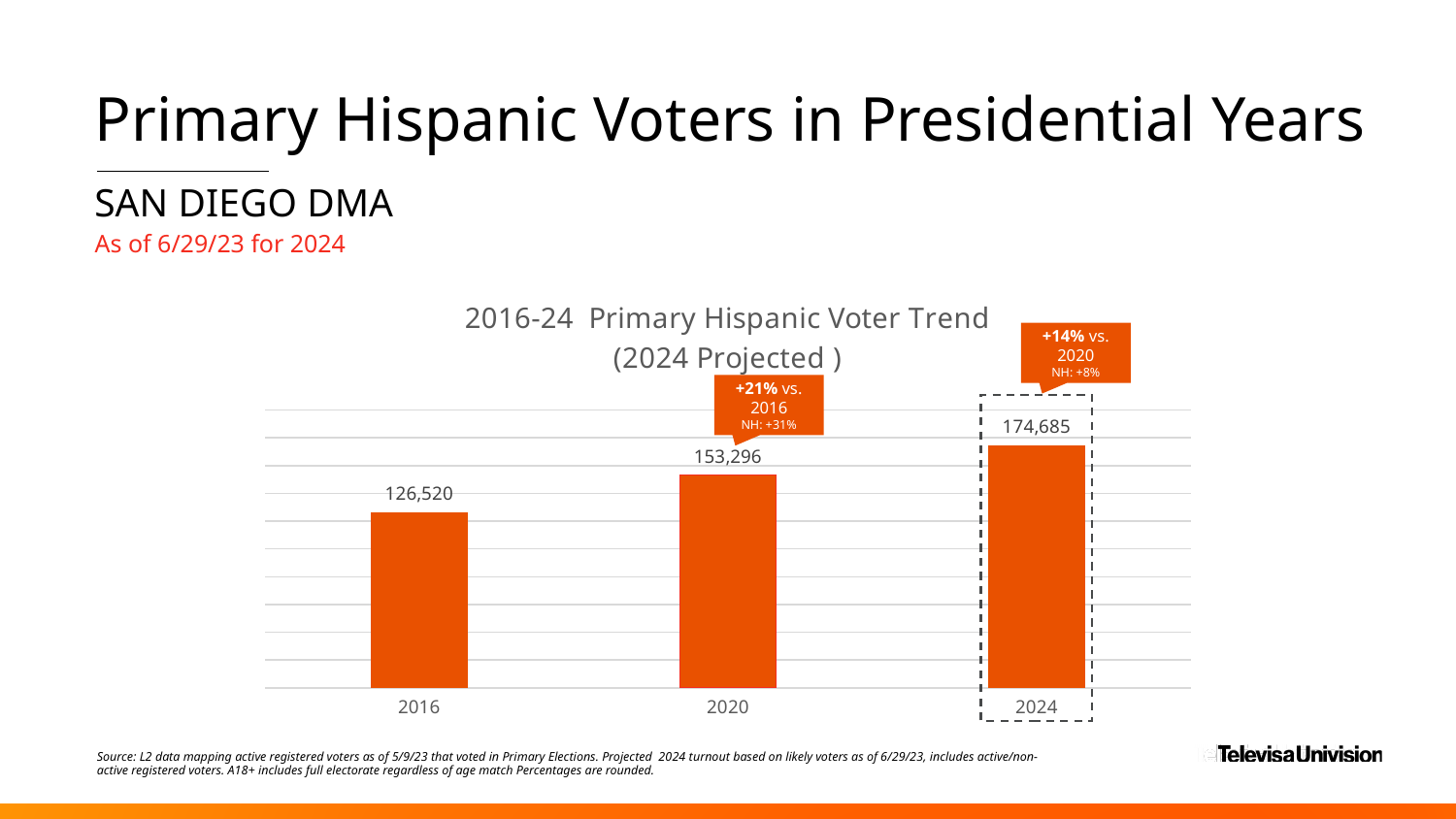
How many years are shown on the chart? 3 Which year has the lowest value? 2016 What kind of chart is this? Bar chart What is the value for 2016? 126,520 What is the difference between the 2020 and 2016 values? 26,776 What is the difference between the 2024 and 2020 values? 21,389 What is the projected value for 2024? 174,685 Which year has the highest value? 2024 What is the title of the chart? 2016-24 Primary Hispanic Voter Trend (2024 Projected) What is the value for 2020? 153,296 Do the values rise or fall from 2016 to 2024? Rise Which is larger, the value for 2016 or the value for 2020? 2020